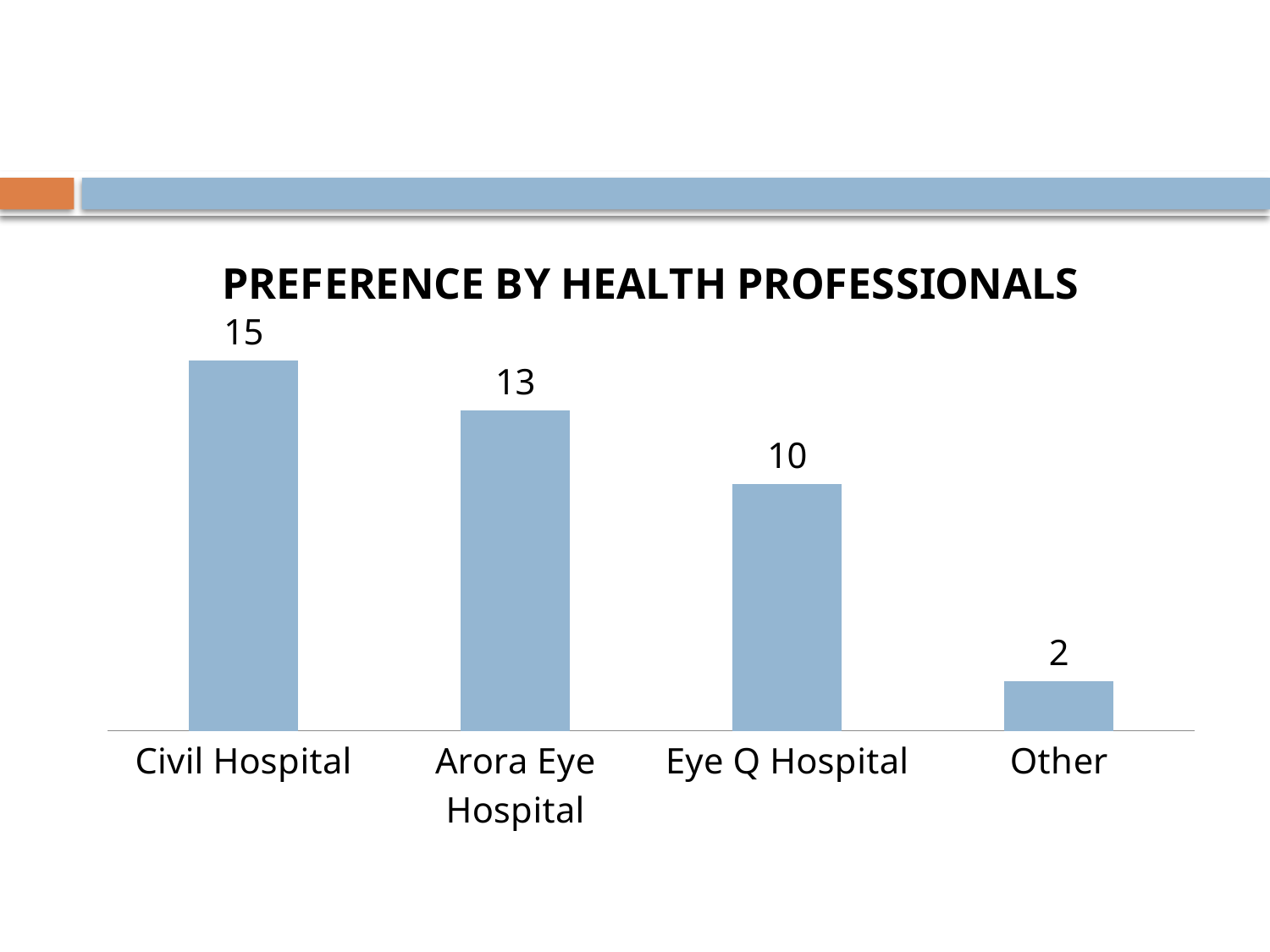
Which category has the lowest value? Other Which category has the highest value? Civil Hospital What kind of chart is shown on the slide? Bar chart What is the title of the chart? PREFERENCE BY HEALTH PROFESSIONALS What is the difference between the values for Civil Hospital and Eye Q Hospital? 5 What is the value for Civil Hospital? 15 What is the value for Arora Eye Hospital? 13 Which is larger, the value for Arora Eye Hospital or the value for Eye Q Hospital? Arora Eye Hospital How many categories are shown in the chart? 4 What is the difference between the values for Arora Eye Hospital and Other? 11 What is the value for Eye Q Hospital? 10 What is the value for Other? 2